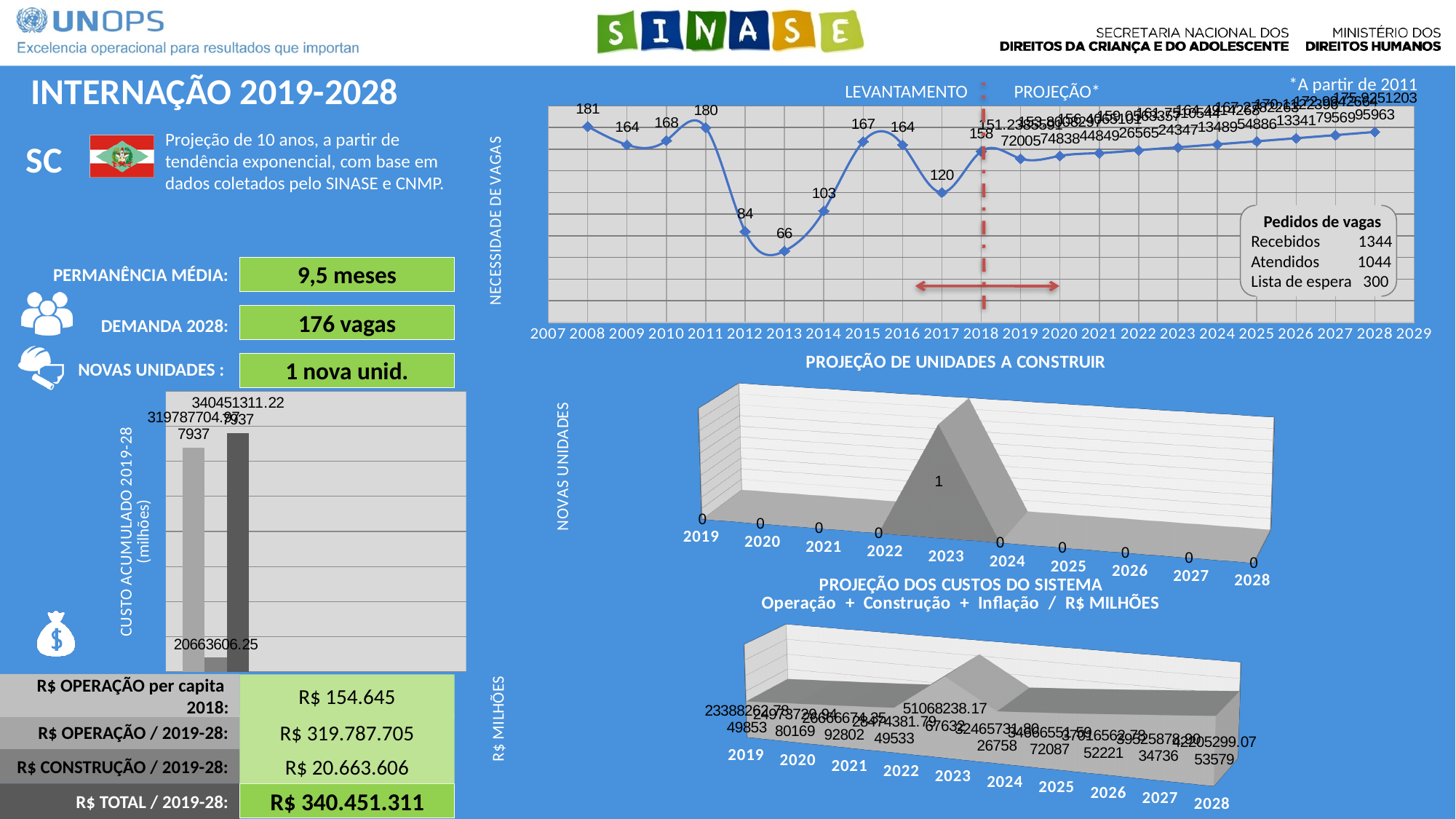
In the PROJEÇÃO DE UNIDADES A CONSTRUIR chart, what is the value for 2023? 1 How many years are shown on the x axis of the PROJEÇÃO DE UNIDADES A CONSTRUIR chart? 10 In the NECESSIDADE DE VAGAS line chart, what is the value for 2008? 181 In the NECESSIDADE DE VAGAS line chart, which is larger, the value for 2014 or the value for 2017? 2017 In the NECESSIDADE DE VAGAS line chart, do the values rise or fall from 2011 to 2013? fall In the NECESSIDADE DE VAGAS chart, what number of 'Recebidos' is shown in the 'Pedidos de vagas' box? 1344 What kind of chart is the NECESSIDADE DE VAGAS chart at the top right? line chart In the NECESSIDADE DE VAGAS line chart, what is the difference between the values for 2011 and 2012? 96 In the NECESSIDADE DE VAGAS line chart, what is the value for 2017? 120 In the NECESSIDADE DE VAGAS line chart, what is the value for 2013? 66 In the PROJEÇÃO DE UNIDADES A CONSTRUIR chart, which year has the highest value? 2023 In the NECESSIDADE DE VAGAS line chart, which year has the lowest value? 2013